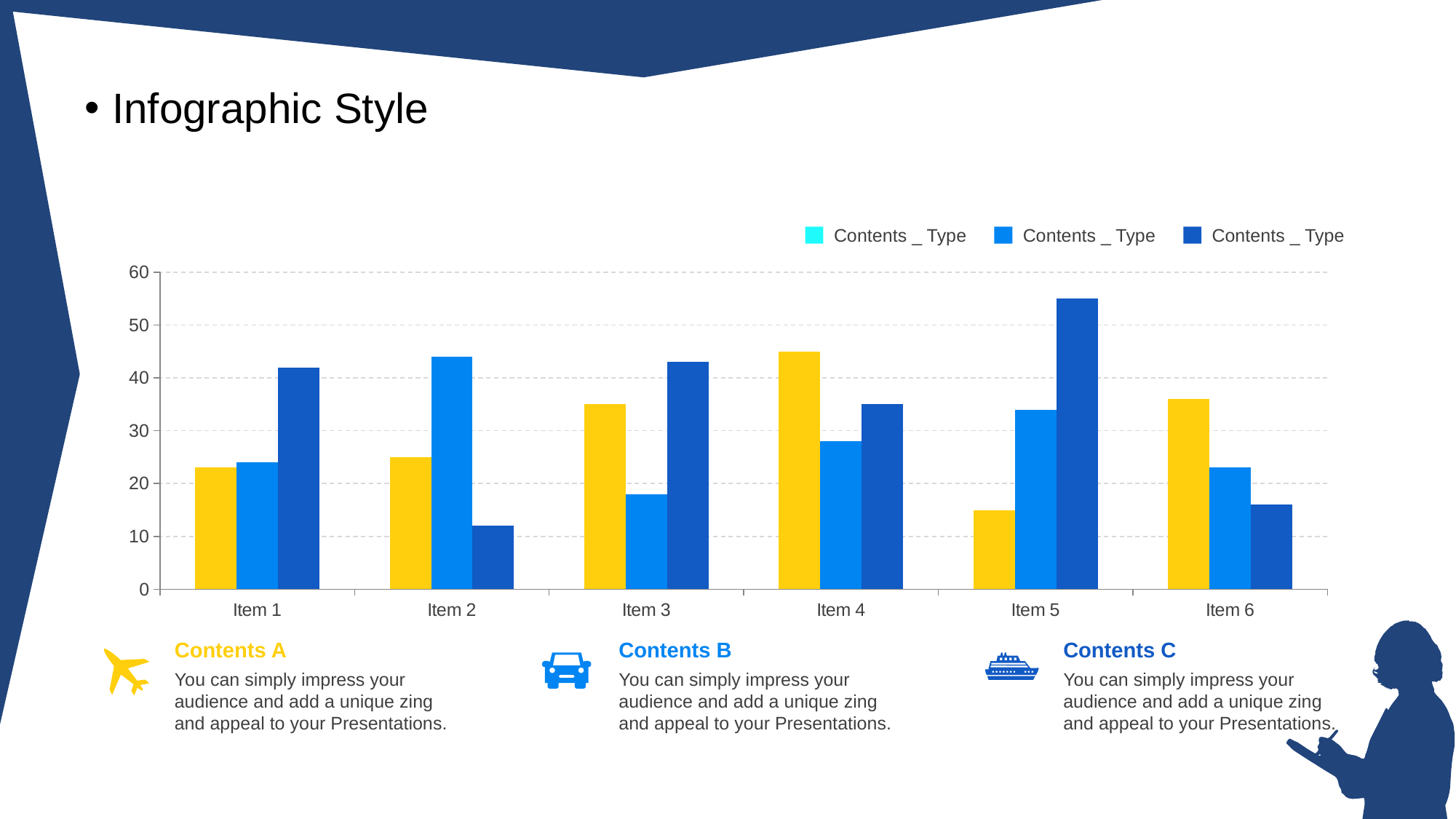
How many items (categories) are shown on the x axis of the chart? 6 For Item 2, which is larger: the yellow bar or the light blue bar? the light blue bar What kind of chart is shown on the slide? bar chart For Item 6, which is larger: the yellow bar or the dark blue bar? the yellow bar What is the highest value shown on the chart's y axis? 60 Which item has the shortest yellow bar? Item 5 Which item has the tallest dark blue bar? Item 5 How many series does the chart's legend list? 3 Is the dark blue bar for Item 2 greater or less than 20? less Is the yellow bar for Item 4 greater or less than 40? greater Is the dark blue bar for Item 5 greater or less than 50? greater Which item has the tallest yellow bar? Item 4